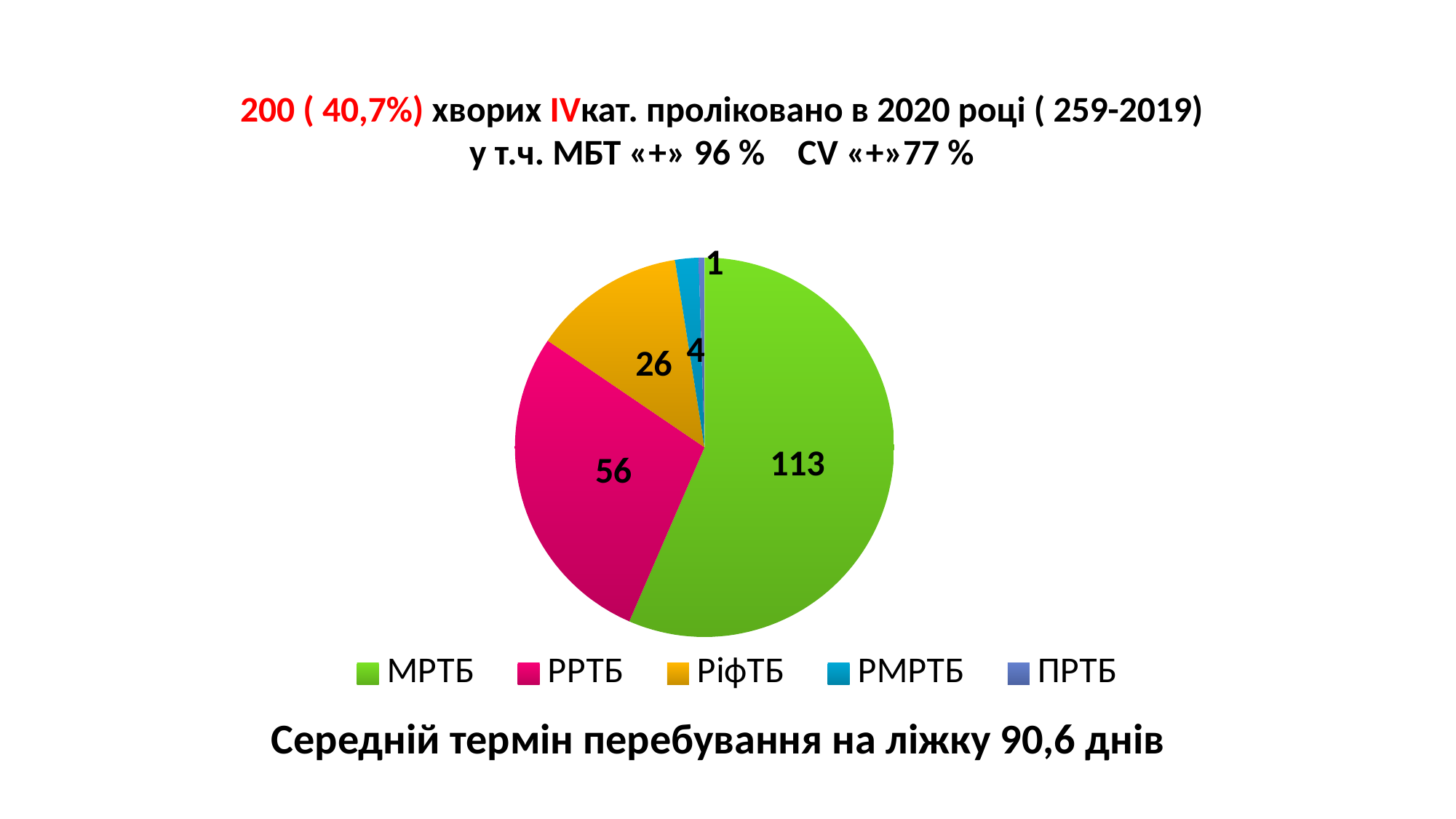
What is the value for РРТБ? 56 How many categories does the pie chart have? 5 What is the difference between the values for МРТБ and РРТБ? 57 What colour is the МРТБ slice? green What kind of chart is shown on the slide? pie chart Which is larger, the value for РРТБ or the value for РіфТБ? РРТБ What is the value for МРТБ? 113 Which category has the smallest slice? ПРТБ What share of the pie does the РРТБ slice represent? 28% Which category has the largest slice? МРТБ What is the value for РіфТБ? 26 What is the value for РМРТБ? 4